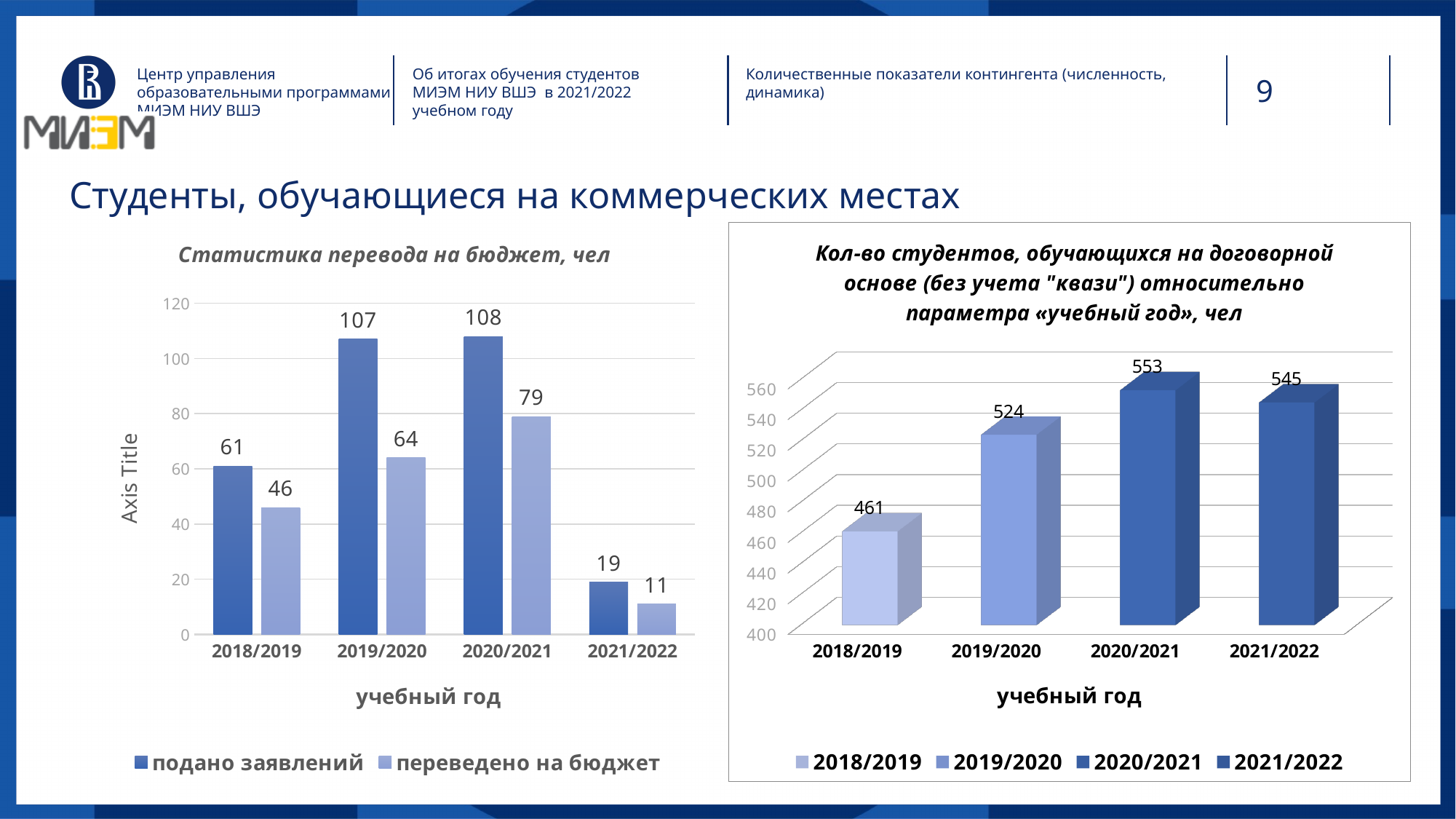
In the left chart 'Статистика перевода на бюджет, чел', which year has the highest value of 'подано заявлений'? 2020/2021 In the left chart 'Статистика перевода на бюджет, чел', which year has the lowest value of 'переведено на бюджет'? 2021/2022 In the left chart 'Статистика перевода на бюджет, чел', what is the difference between 'подано заявлений' and 'переведено на бюджет' in 2019/2020? 43 In the left chart 'Статистика перевода на бюджет, чел', how many series does the legend list? 2 In the left chart 'Статистика перевода на бюджет, чел', what is the value of 'переведено на бюджет' for 2020/2021? 79 In the left chart 'Статистика перевода на бюджет, чел', what is the value of 'подано заявлений' for 2019/2020? 107 In the right chart, is the value for 2019/2020 larger or smaller than the value for 2021/2022? smaller What type of chart is the right chart on the slide? bar chart In the right chart, which academic year has the highest number of students studying on a contract basis? 2020/2021 In the right chart, what is the difference between the values for 2020/2021 and 2021/2022? 8 In the right chart, what is the number of students studying on a contract basis in 2018/2019? 461 In the left chart 'Статистика перевода на бюджет, чел', what is the label of the vertical axis? Axis Title